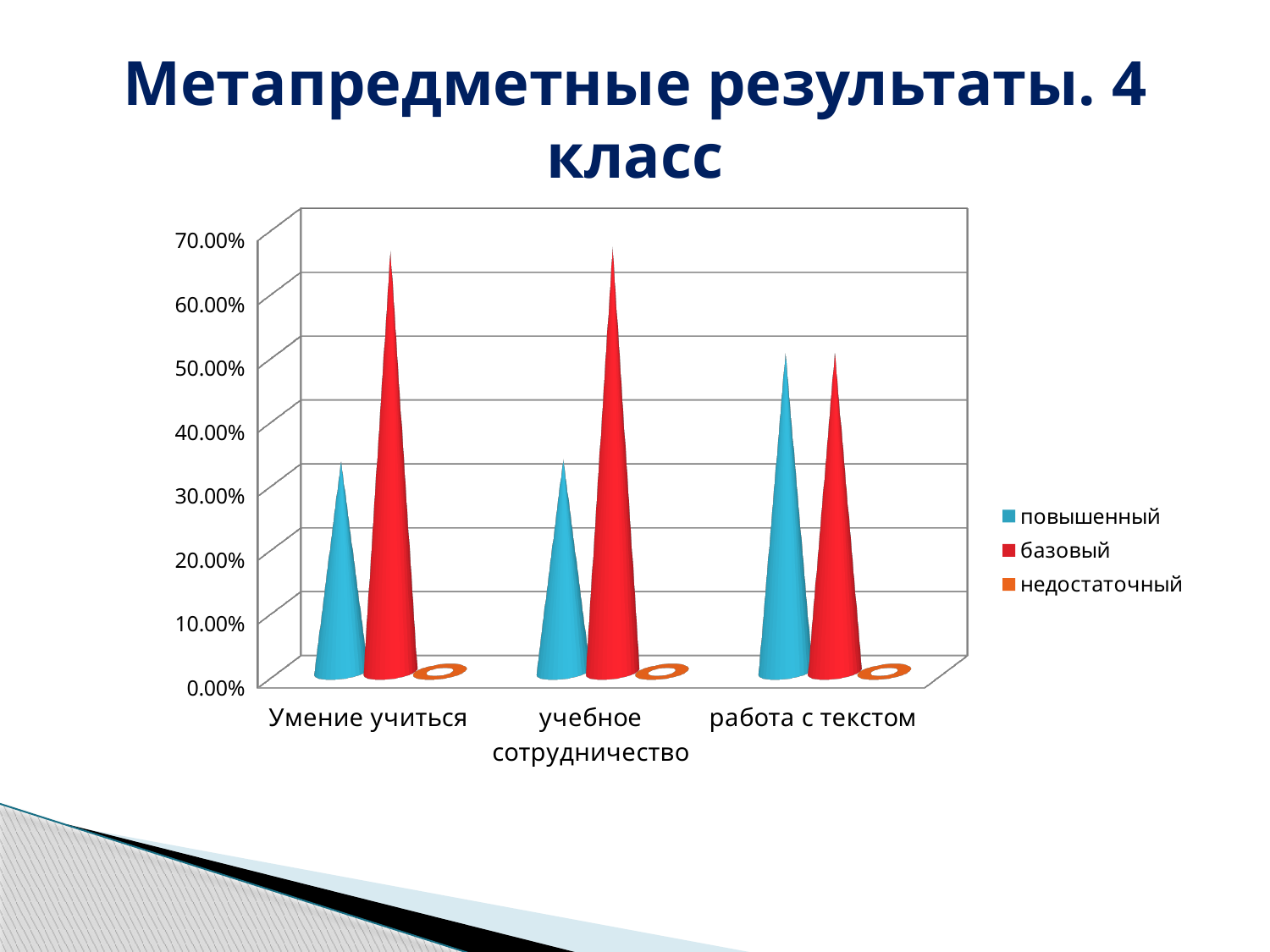
Is the value for 'базовый' in 'Умение учиться' greater or less than 60.00%? greater For 'Умение учиться', which is larger: 'повышенный' or 'базовый'? базовый What is the title of the chart on the slide? Метапредметные результаты. 4 класс Is the value for 'повышенный' in 'Умение учиться' greater or less than 40.00%? less Which colour represents the series 'базовый' in the legend? red How many series does the legend list? 3 How many categories are shown on the x axis? 3 Is the value for 'повышенный' in 'работа с текстом' greater or less than 40.00%? greater Which category has the lowest value for 'базовый'? работа с текстом Which category has the highest value for 'повышенный'? работа с текстом What kind of chart is shown on the slide? bar chart